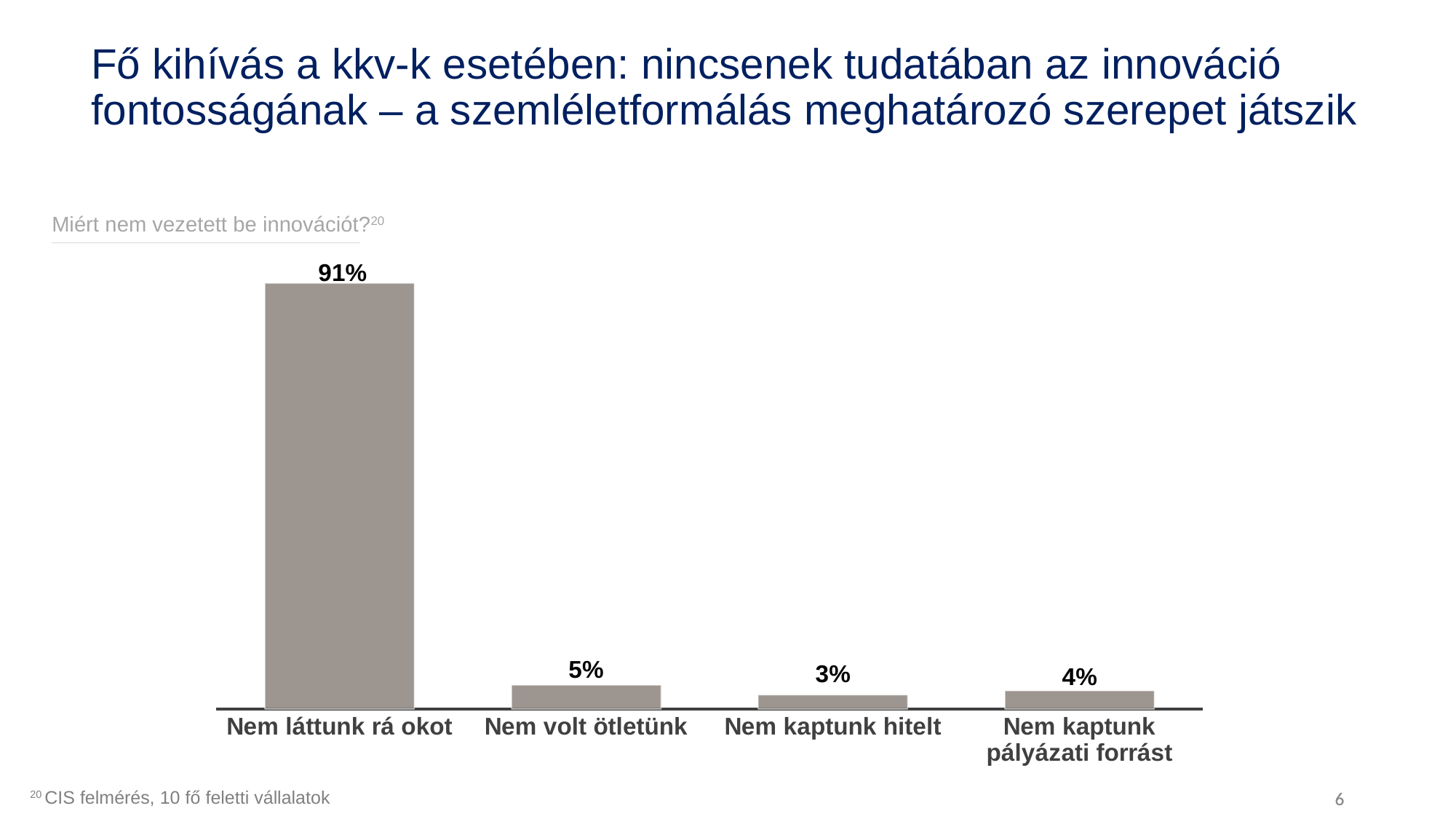
What is the difference between the values for "Nem kaptunk pályázati forrást" and "Nem kaptunk hitelt"? 1% How many categories are shown in the chart? 4 What kind of chart is shown on the slide? Bar chart What is the value for "Nem kaptunk pályázati forrást"? 4% What is the value for "Nem kaptunk hitelt"? 3% Which category has the lowest value? Nem kaptunk hitelt What is the title of the chart? Miért nem vezetett be innovációt? What is the difference between the values for "Nem láttunk rá okot" and "Nem volt ötletünk"? 86% Which is larger, the value for "Nem volt ötletünk" or the value for "Nem kaptunk pályázati forrást"? Nem volt ötletünk What is the value for "Nem volt ötletünk"? 5% Which category has the highest value? Nem láttunk rá okot What is the value for "Nem láttunk rá okot"? 91%